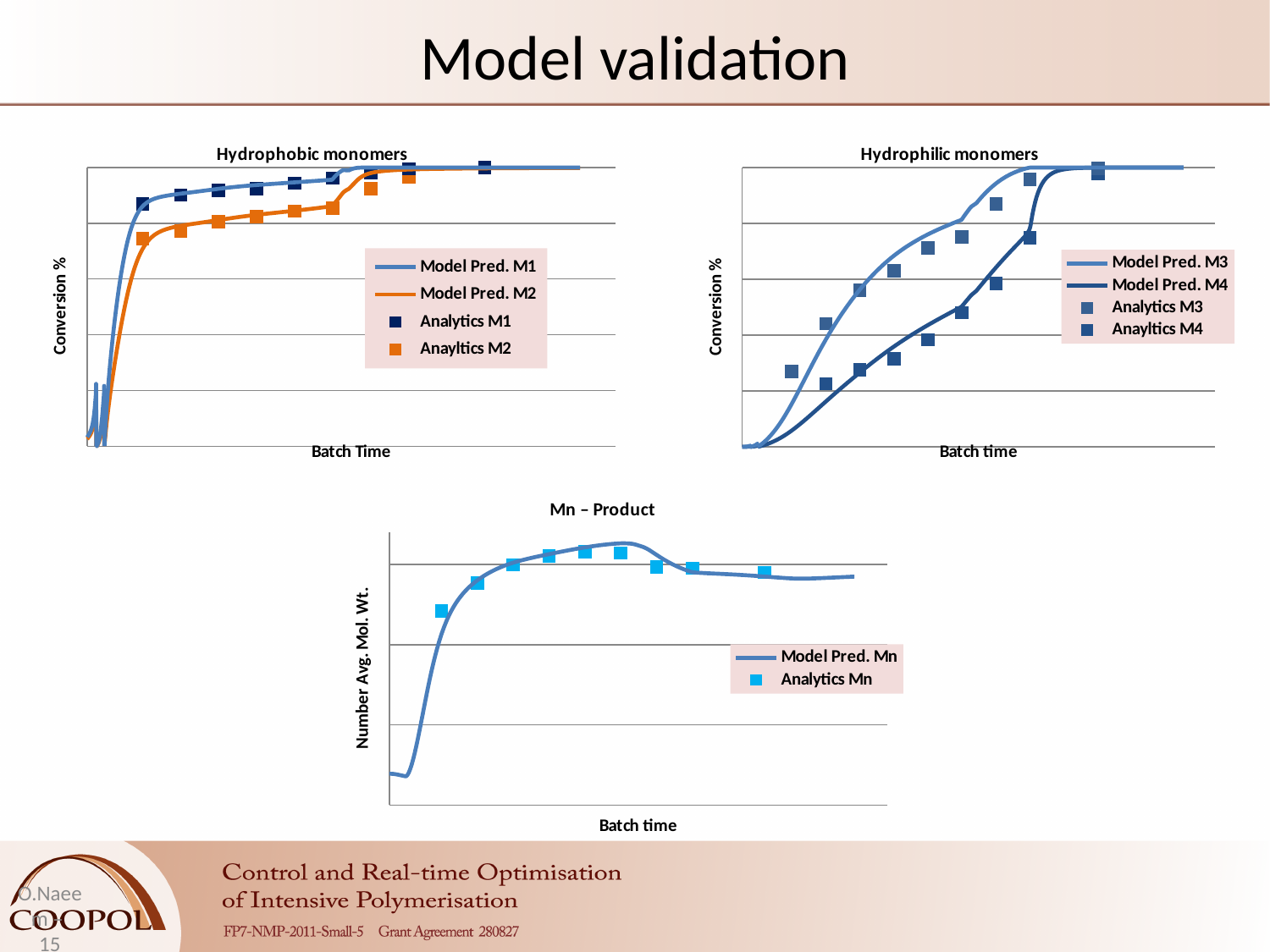
In the "Hydrophilic monomers" chart, does the Model Pred. M4 line rise or fall along the x axis? rise What is the y-axis label of the "Mn – Product" chart? Number Avg. Mol. Wt. How many charts are shown on the slide? 3 In the "Hydrophilic monomers" chart, which line is higher in the middle of the batch time, Model Pred. M3 or Model Pred. M4? Model Pred. M3 In the "Hydrophobic monomers" chart, which model prediction line is higher in the middle of the batch time, Model Pred. M1 or Model Pred. M2? Model Pred. M1 How many series does the legend of the "Hydrophobic monomers" chart list? 4 In the "Hydrophobic monomers" chart, does the Model Pred. M1 line rise or fall along the x axis? rise How many series does the legend of the "Mn – Product" chart list? 2 What kind of chart is the "Hydrophobic monomers" chart? line chart How many series does the legend of the "Hydrophilic monomers" chart list? 4 What is the y-axis label of the "Hydrophobic monomers" chart? Conversion %